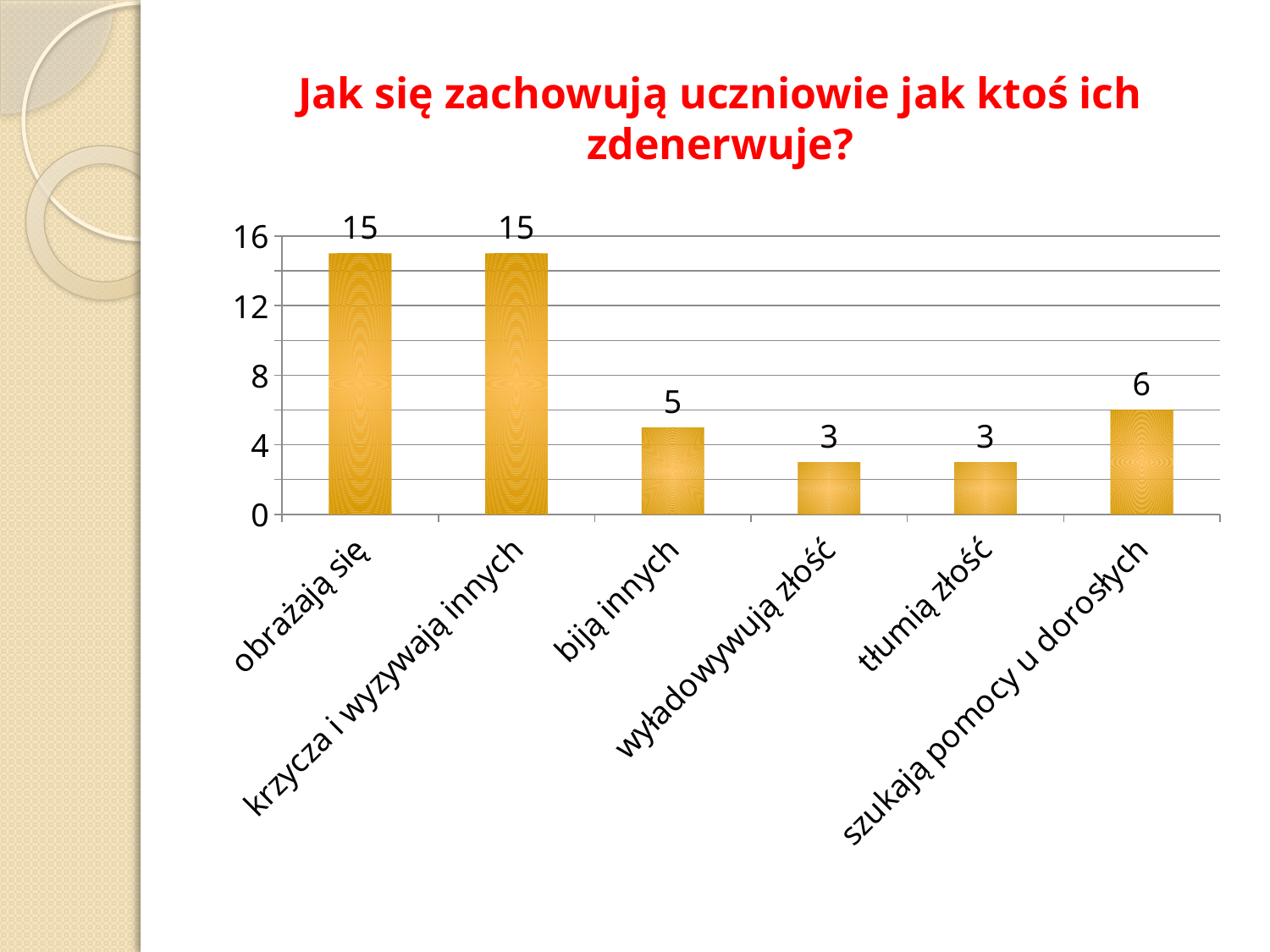
What is the value for "obrażają się"? 15 What is the value for "tłumią złość"? 3 Is the value for "krzycza i wyzywają innych" greater or less than 12? greater What is the title of the chart? Jak się zachowują uczniowie jak ktoś ich zdenerwuje? Which category has the lowest value, "biją innych" or "wyładowywują złość"? wyładowywują złość How many categories are shown on the x axis? 6 What is the difference between the values for "obrażają się" and "biją innych"? 10 What is the difference between the values for "szukają pomocy u dorosłych" and "tłumią złość"? 3 What kind of chart is shown on the slide? bar chart Which is larger, the value for "szukają pomocy u dorosłych" or the value for "biją innych"? szukają pomocy u dorosłych What is the value for "biją innych"? 5 What is the value for "szukają pomocy u dorosłych"? 6